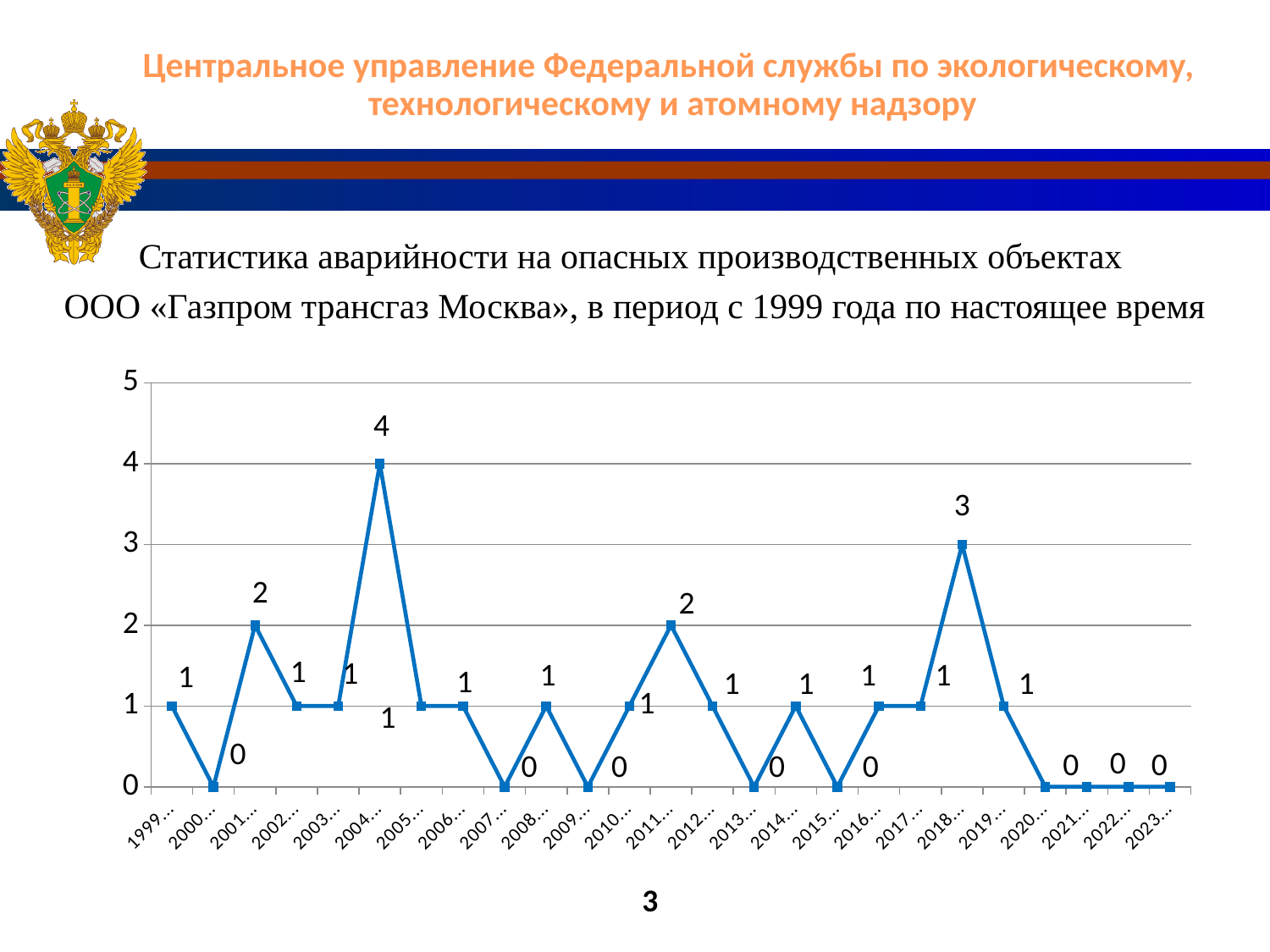
What kind of chart is shown on the slide? line chart Do the values rise or fall from 2018 to 2020? fall What is the difference between the values for 2004 and 2018? 1 What is the value for 2011? 2 Which year has the highest value? 2004 Which is larger, the value for 2001 or the value for 2002? 2001 How many years (data points) are plotted on the chart? 25 What is the highest value shown on the vertical axis? 5 What is the value for 2004? 4 What is the value for 2023? 0 What is the lowest value plotted on the chart? 0 What is the value for 2018? 3